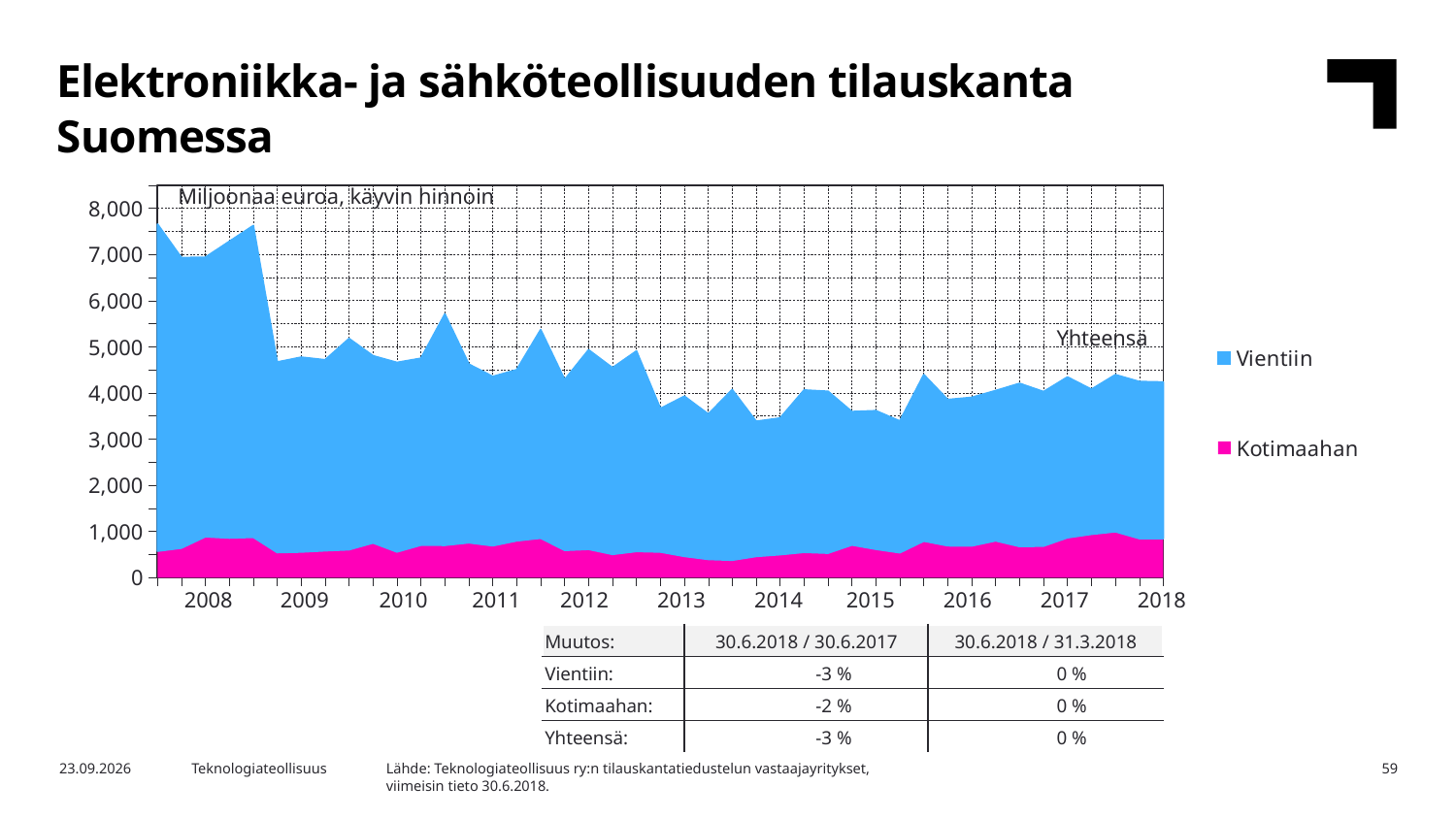
How many year labels are shown on the x axis? 11 Is the total (Yhteensä) value at 2018 greater or less than 5,000? less What kind of chart is shown on the slide? Stacked area chart Is the Kotimaahan value at 2018 greater or less than 1,000? less Is the total (Yhteensä) value at 2013 greater or less than 5,000? less Which two series are listed in the chart legend? Vientiin and Kotimaahan Does the total order backlog (Yhteensä) rise or fall overall from 2008 to 2018? Fall How many series does the chart legend list? 2 Is the total (Yhteensä) value at 2008 larger or smaller than at 2018? Larger What unit is stated for the values in the chart? Miljoonaa euroa, käyvin hinnoin Which series is larger throughout the chart, Vientiin or Kotimaahan? Vientiin